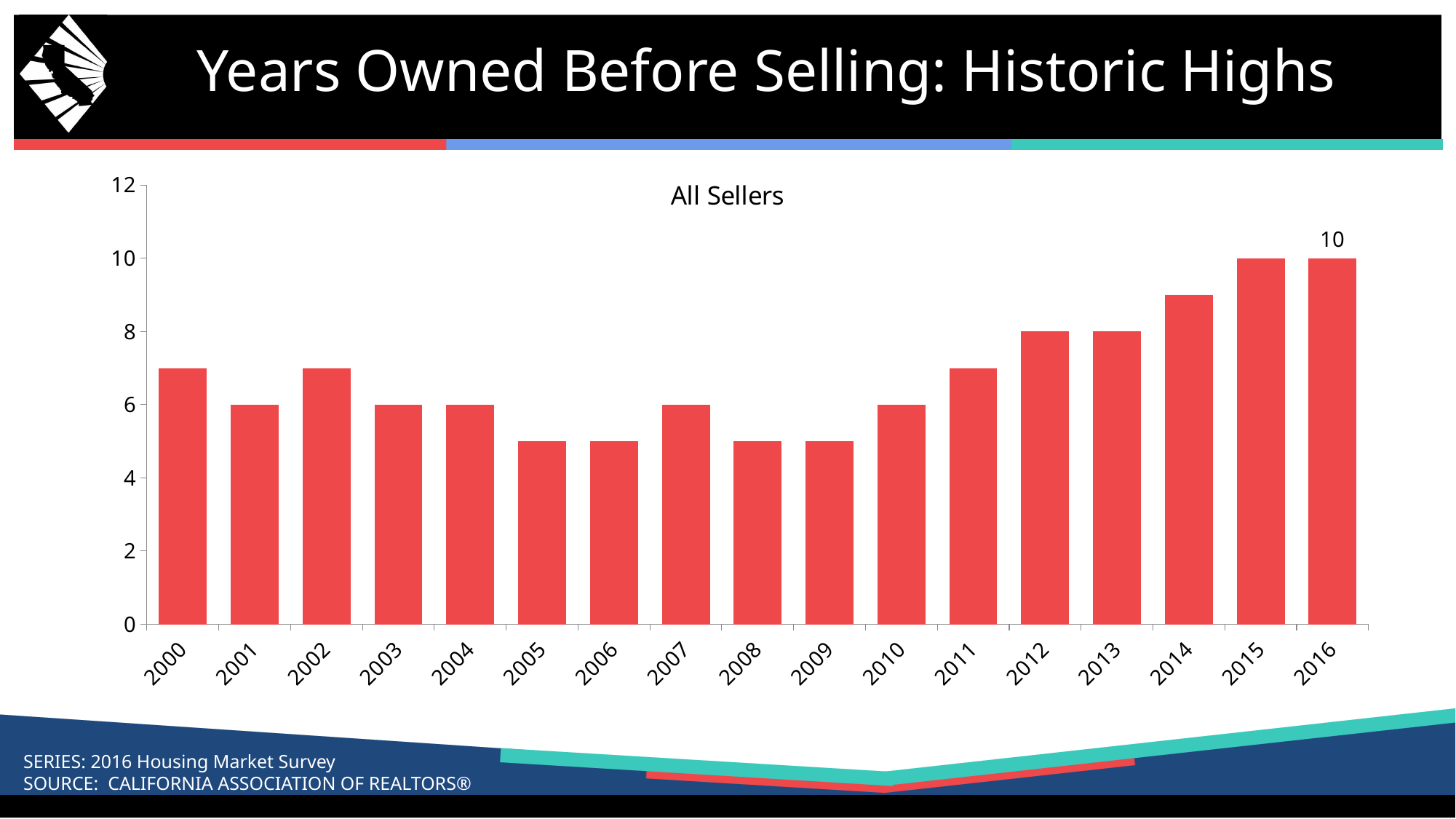
Is the value for 2005 greater or less than 6? less What is the value for 2001? 6 What is the title shown above the chart's plot area? All Sellers Which is larger, the value for 2012 or the value for 2007? 2012 What is the value for 2013? 8 Do the values rise or fall from 2010 to 2016? rise What is the value for 2015? 10 How many years are shown on the x axis? 17 What is the difference between the value for 2016 and the value for 2001? 4 What is the value for 2016? 10 Is the value for 2014 greater or less than 8? greater What kind of chart is shown on the slide? bar chart